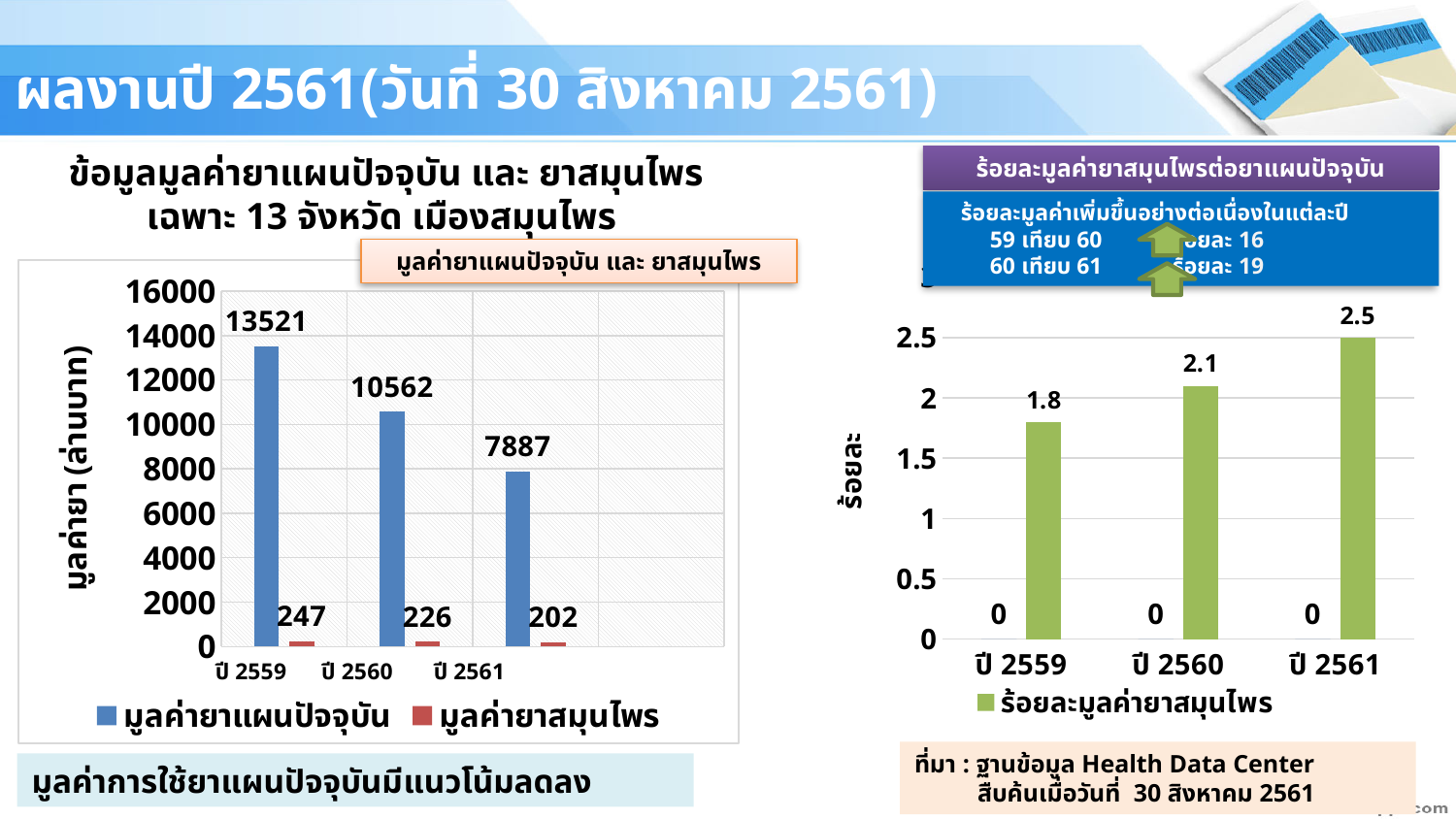
In the left chart (มูลค่ายาแผนปัจจุบัน และ ยาสมุนไพร), does the value of มูลค่ายาแผนปัจจุบัน rise or fall from ปี 2559 to ปี 2561? fall In the right chart (ร้อยละมูลค่ายาสมุนไพรต่อยาแผนปัจจุบัน), which year has the highest value for ร้อยละมูลค่ายาสมุนไพร? ปี 2561 In the left chart (มูลค่ายาแผนปัจจุบัน และ ยาสมุนไพร), how many series does the legend list? 2 In the right chart (ร้อยละมูลค่ายาสมุนไพรต่อยาแผนปัจจุบัน), what is the value of ร้อยละมูลค่ายาสมุนไพร for ปี 2560? 2.1 In the left chart (มูลค่ายาแผนปัจจุบัน และ ยาสมุนไพร), what is the y-axis title? มูลค่ายา (ล้านบาท) In the right chart (ร้อยละมูลค่ายาสมุนไพรต่อยาแผนปัจจุบัน), how many years are shown on the x axis? 3 In the left chart (มูลค่ายาแผนปัจจุบัน และ ยาสมุนไพร), which year has the lowest value for มูลค่ายาแผนปัจจุบัน? ปี 2561 In the left chart (มูลค่ายาแผนปัจจุบัน และ ยาสมุนไพร), what is the value of มูลค่ายาสมุนไพร for ปี 2561? 202 In the left chart (มูลค่ายาแผนปัจจุบัน และ ยาสมุนไพร), what is the difference between the มูลค่ายาแผนปัจจุบัน values for ปี 2559 and ปี 2560? 2959 What kind of chart is the right chart (ร้อยละมูลค่ายาสมุนไพรต่อยาแผนปัจจุบัน)? bar chart In the right chart (ร้อยละมูลค่ายาสมุนไพรต่อยาแผนปัจจุบัน), what is the difference between the ร้อยละมูลค่ายาสมุนไพร values for ปี 2561 and ปี 2559? 0.7 In the left chart (มูลค่ายาแผนปัจจุบัน และ ยาสมุนไพร), what is the value of มูลค่ายาแผนปัจจุบัน for ปี 2559? 13521